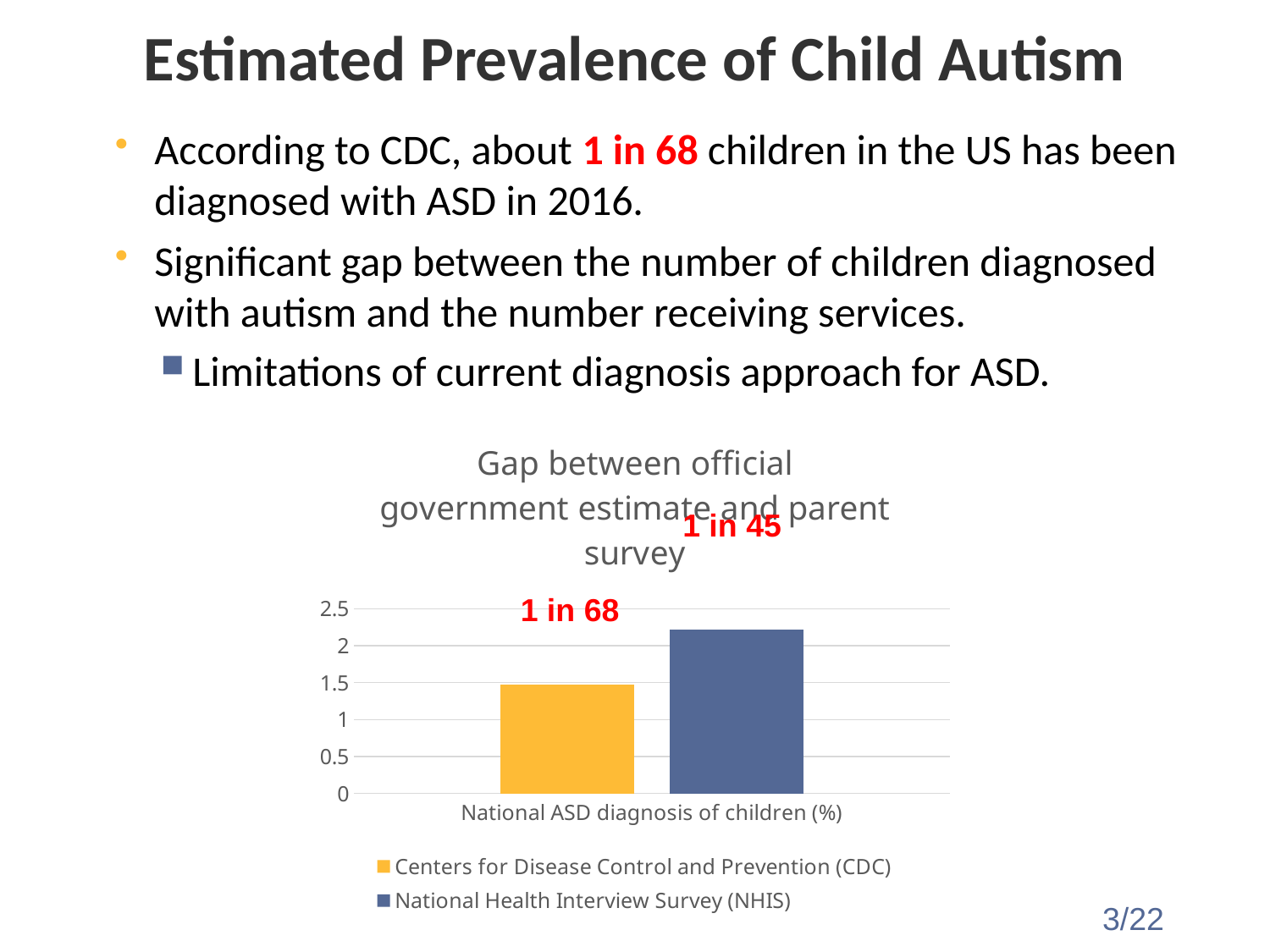
How many series does the chart legend list? 2 Is the value for Centers for Disease Control and Prevention (CDC) greater or less than 1? greater Which series has the highest value in the chart? National Health Interview Survey (NHIS) Is the value for Centers for Disease Control and Prevention (CDC) greater or less than 2? less Is the value for National Health Interview Survey (NHIS) greater or less than 2? greater What is the title of the chart? Gap between official government estimate and parent survey What is the category label on the x axis of the chart? National ASD diagnosis of children (%) How many categories are shown on the x axis of the chart? 1 What kind of chart is shown on the slide? bar chart Which series has the lowest value in the chart? Centers for Disease Control and Prevention (CDC) Which series has the taller bar, Centers for Disease Control and Prevention (CDC) or National Health Interview Survey (NHIS)? National Health Interview Survey (NHIS)